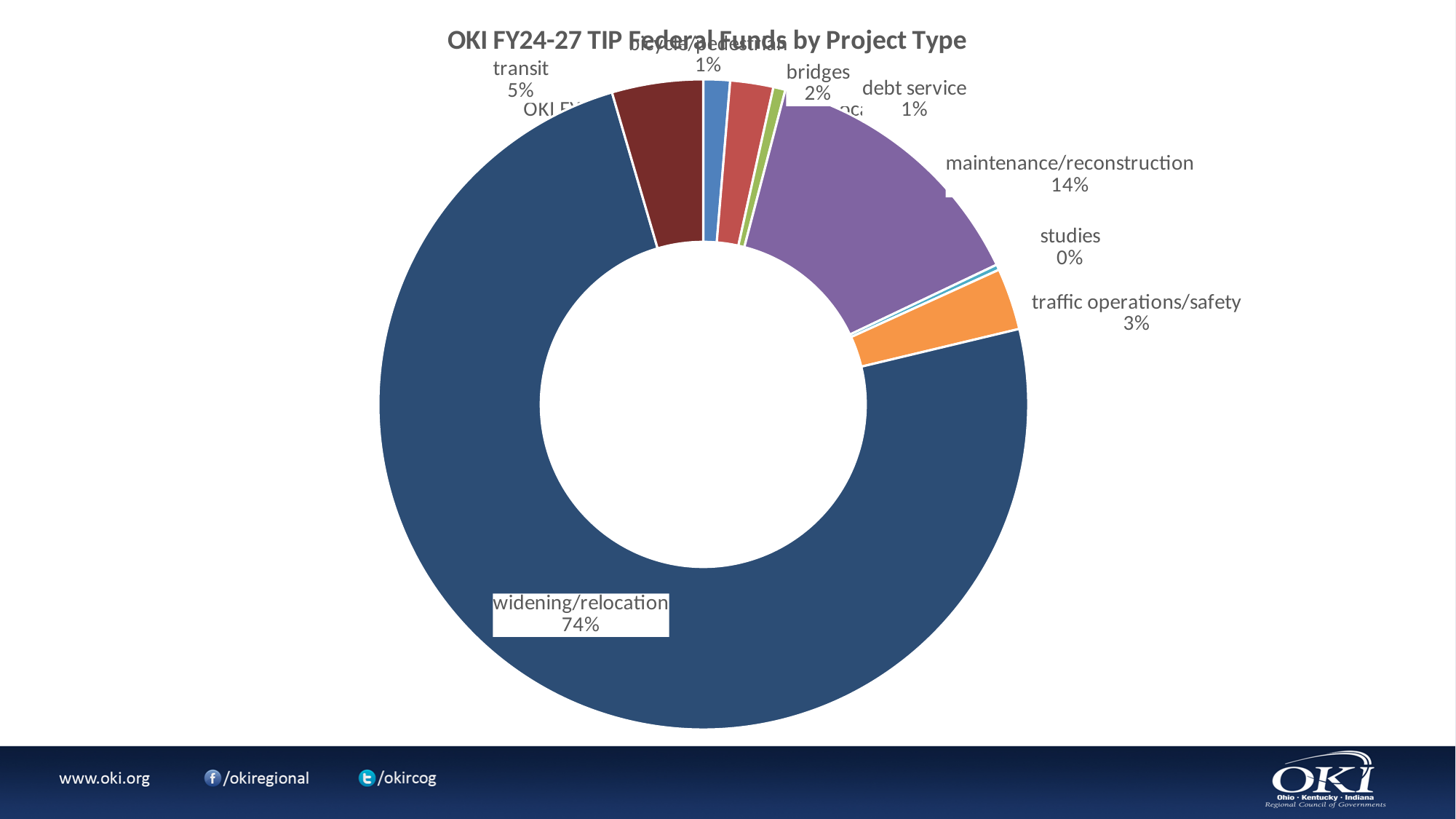
What share of federal funds goes to widening/relocation? 74% What percentage is shown for maintenance/reconstruction? 14% How many project type categories are labelled on the chart? 8 Which project type receives the largest share of federal funds? widening/relocation What percentage is shown for traffic operations/safety? 3% What is the difference in percentage points between widening/relocation and maintenance/reconstruction? 60 Which project type has the smallest labelled share? studies What kind of chart is shown on the slide? Pie (doughnut) chart What share is shown for bridges? 2% Which has a larger share, transit or traffic operations/safety? transit What is the title of the chart? OKI FY24-27 TIP Federal Funds by Project Type What share is labelled for transit? 5%